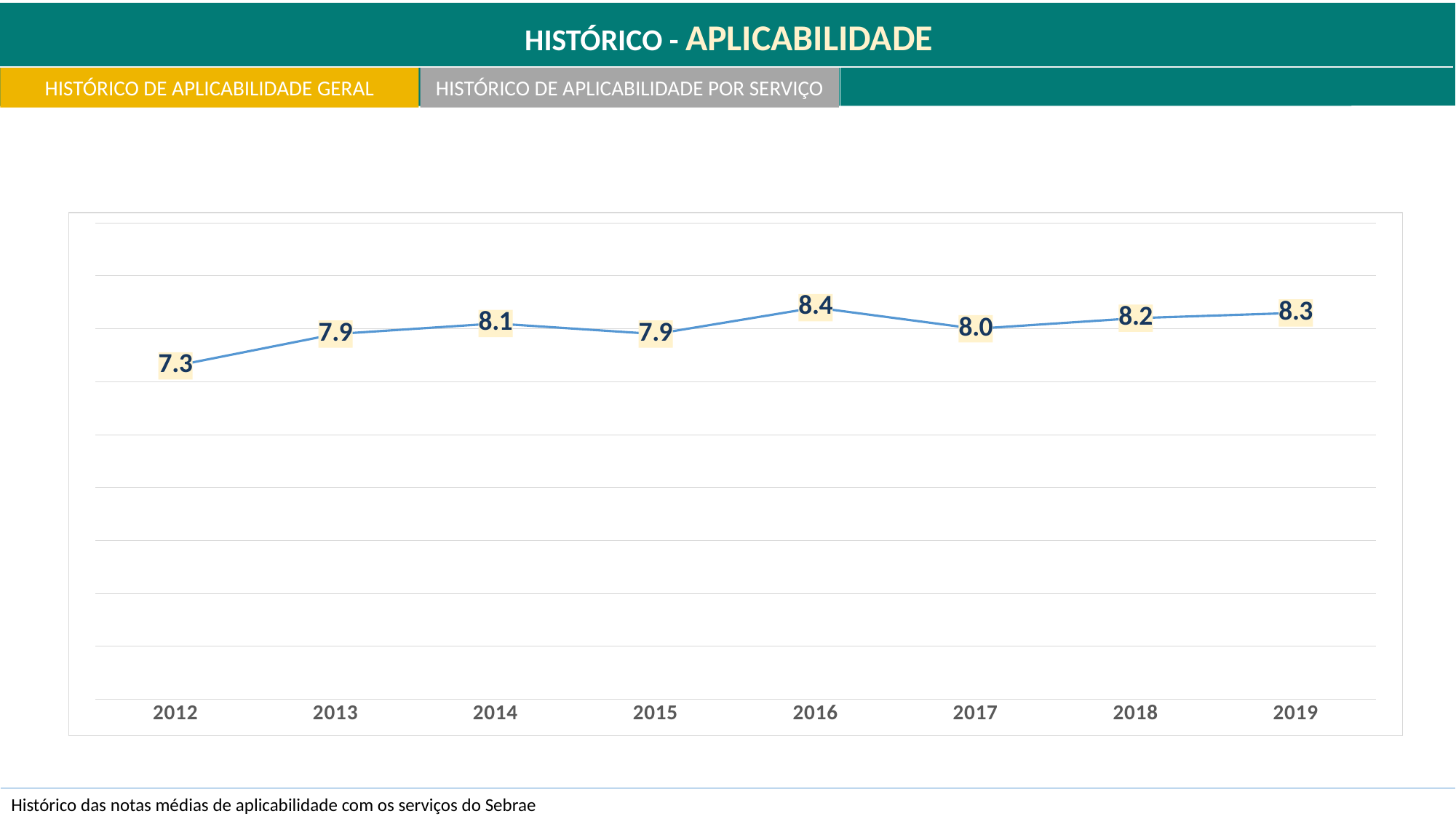
Which is larger, the value for 2014 or the value for 2015? 2014 What is the value for 2016? 8.4 Which year has the lowest value? 2012 What is the difference between the values for 2019 and 2018? 0.1 What kind of chart is shown on the slide? line chart Which year has the highest value? 2016 What is the value for 2017? 8.0 What is the value for 2019? 8.3 How many years are plotted on the chart? 8 What is the difference between the values for 2016 and 2012? 1.1 Do the values generally rise or fall from 2012 to 2019? rise What is the value for 2012? 7.3